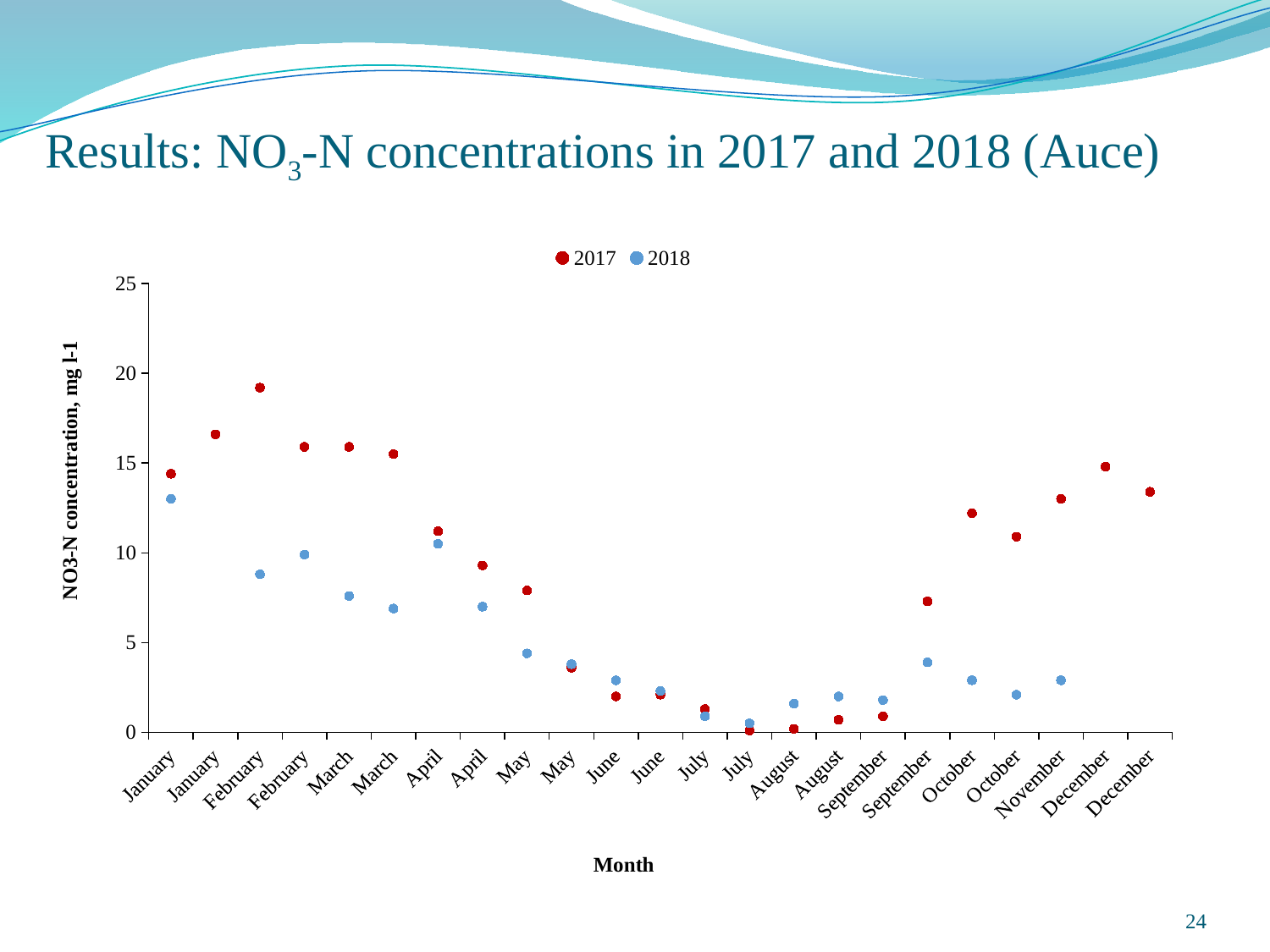
What is the label of the vertical axis? NO3-N concentration, mg l-1 What kind of chart is shown on the slide? scatter chart At the first February point, which series has the larger value, 2017 or 2018? 2017 Do the 2017 values rise or fall from January to July? fall Is the 2017 value for the second July point greater or less than 5? less How many series does the legend list? 2 Is the 2018 value for the first January point greater or less than 10? greater Is the 2017 value for the first February point greater or less than 15? greater Which two series are listed in the legend? 2017 and 2018 At the first August point, which series has the larger value, 2017 or 2018? 2018 At which month label does the 2017 series reach its highest value? February (first February point)